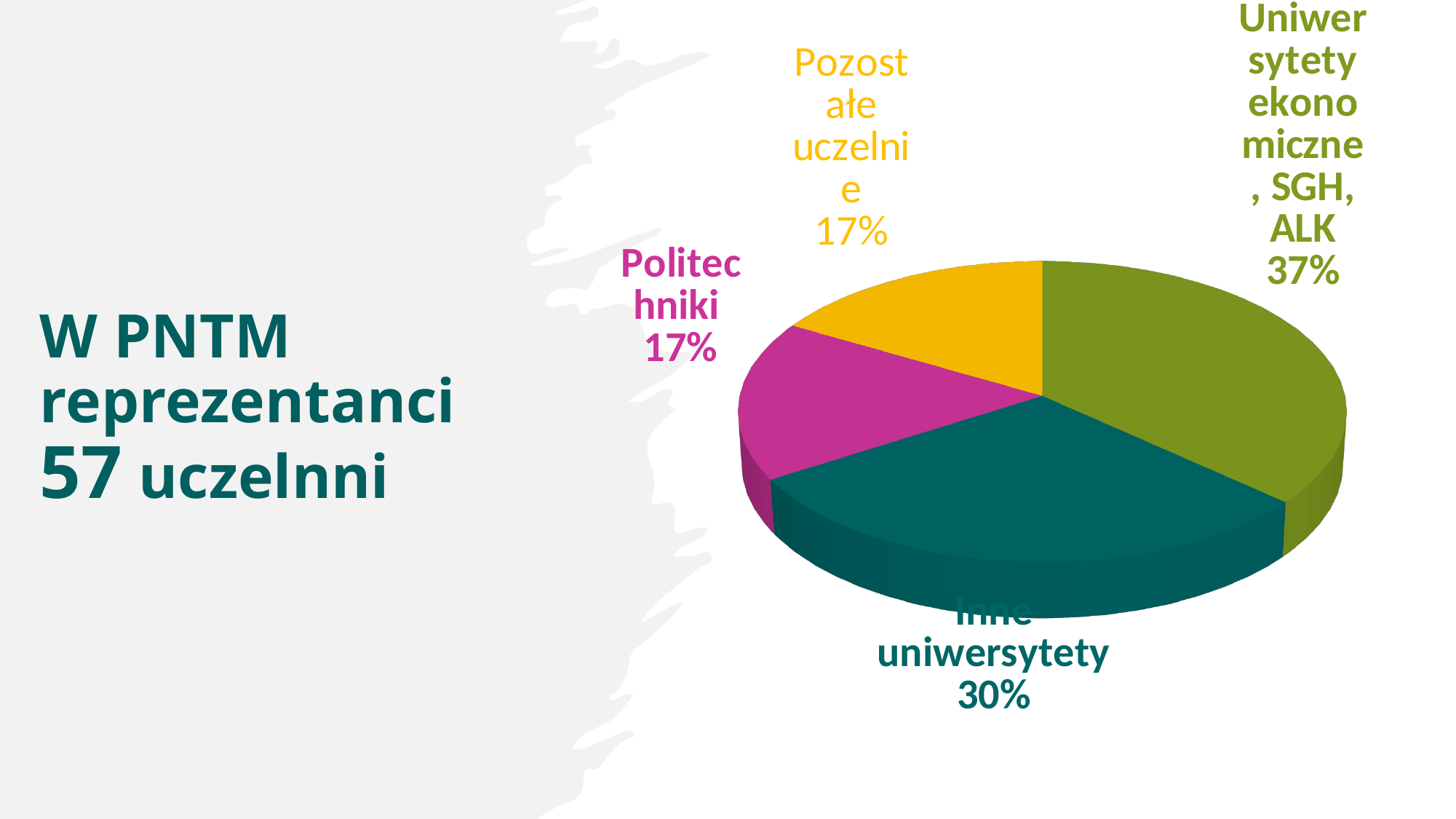
What type of chart is shown on the slide? Pie chart What percentage is shown for the slice labelled Uniwersytety ekonomiczne, SGH, ALK? 37% Which two categories have the same share of the pie? Politechniki and Pozostałe uczelnie What share of the pie does the slice for Inne uniwersytety represent? 30% What is the difference in percentage points between Inne uniwersytety and Politechniki? 13 percentage points What percentage is shown for Pozostałe uczelnie? 17% Which slice is larger: Inne uniwersytety or Politechniki? Inne uniwersytety Which category has the largest slice of the pie? Uniwersytety ekonomiczne, SGH, ALK What percentage is shown for Politechniki? 17% According to the text on the slide, how many universities (uczelni) are represented in PNTM? 57 How many slices does the pie chart have? 4 What is the difference in percentage points between the Uniwersytety ekonomiczne, SGH, ALK slice and the Inne uniwersytety slice? 7 percentage points